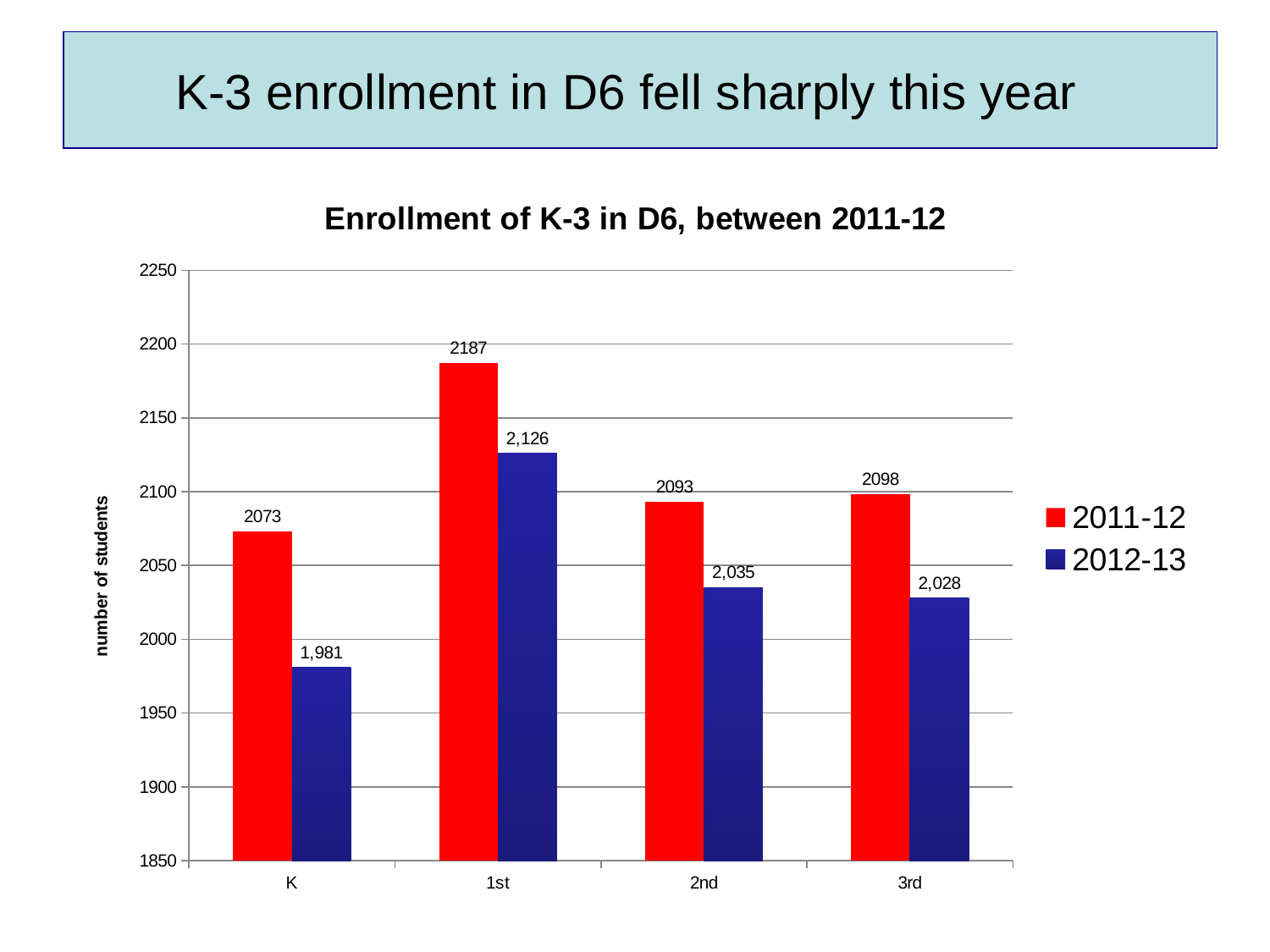
How many grade categories are shown on the x axis? 4 What kind of chart is shown on the slide? Bar chart Which grade had the highest 2011-12 enrollment? 1st What was the 2011-12 enrollment for 1st grade? 2187 Which is larger, the 2012-13 enrollment for 1st grade or the 2011-12 enrollment for 2nd grade? 2012-13 enrollment for 1st grade What was the 2012-13 enrollment for 3rd grade? 2,028 What is the difference between the 2011-12 and 2012-13 enrollment for 2nd grade? 58 How many series does the legend list? 2 What is the difference between the 2011-12 and 2012-13 enrollment for K? 92 Which grade had the lowest 2012-13 enrollment? K What is the label on the vertical axis? number of students What was the 2012-13 enrollment for K? 1,981